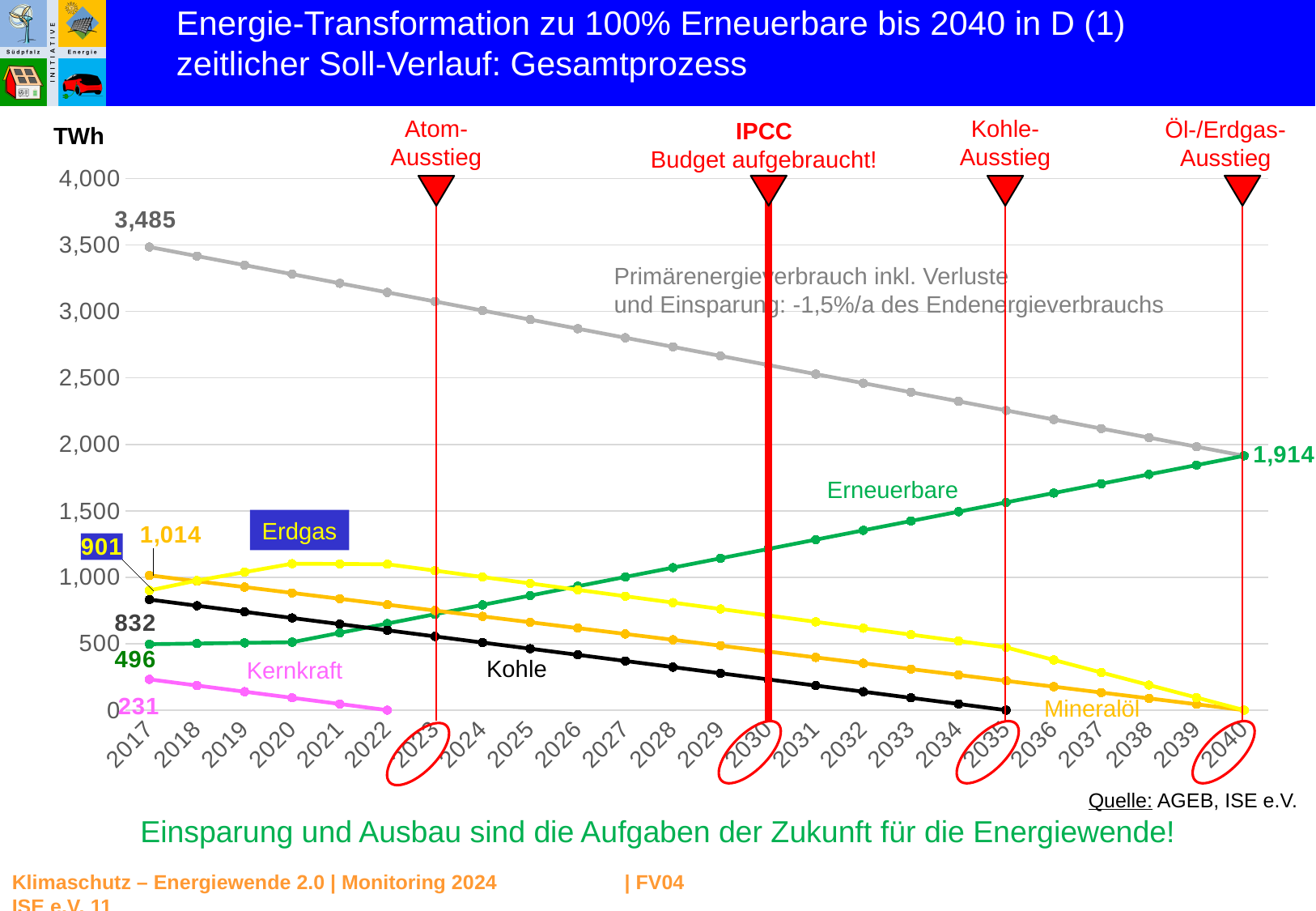
In 2017, which is larger: Mineralöl or Erdgas? Mineralöl What is the value of Kernkraft in 2017? 231 What is the value of Kohle in 2017? 832 By how much does the Erneuerbare line increase from 2017 to 2040? 1,418 What kind of chart is shown on the slide? line chart What is the value of Mineralöl in 2017? 1,014 What is the value of Erneuerbare in 2017? 496 What is the value of the Primärenergieverbrauch line in 2017? 3,485 Does the Primärenergieverbrauch line rise or fall from 2017 to 2040? fall Is the value of Kohle in 2030 greater or less than 500? less How many years are shown on the x axis? 24 What value does the Erneuerbare line reach in 2040? 1,914